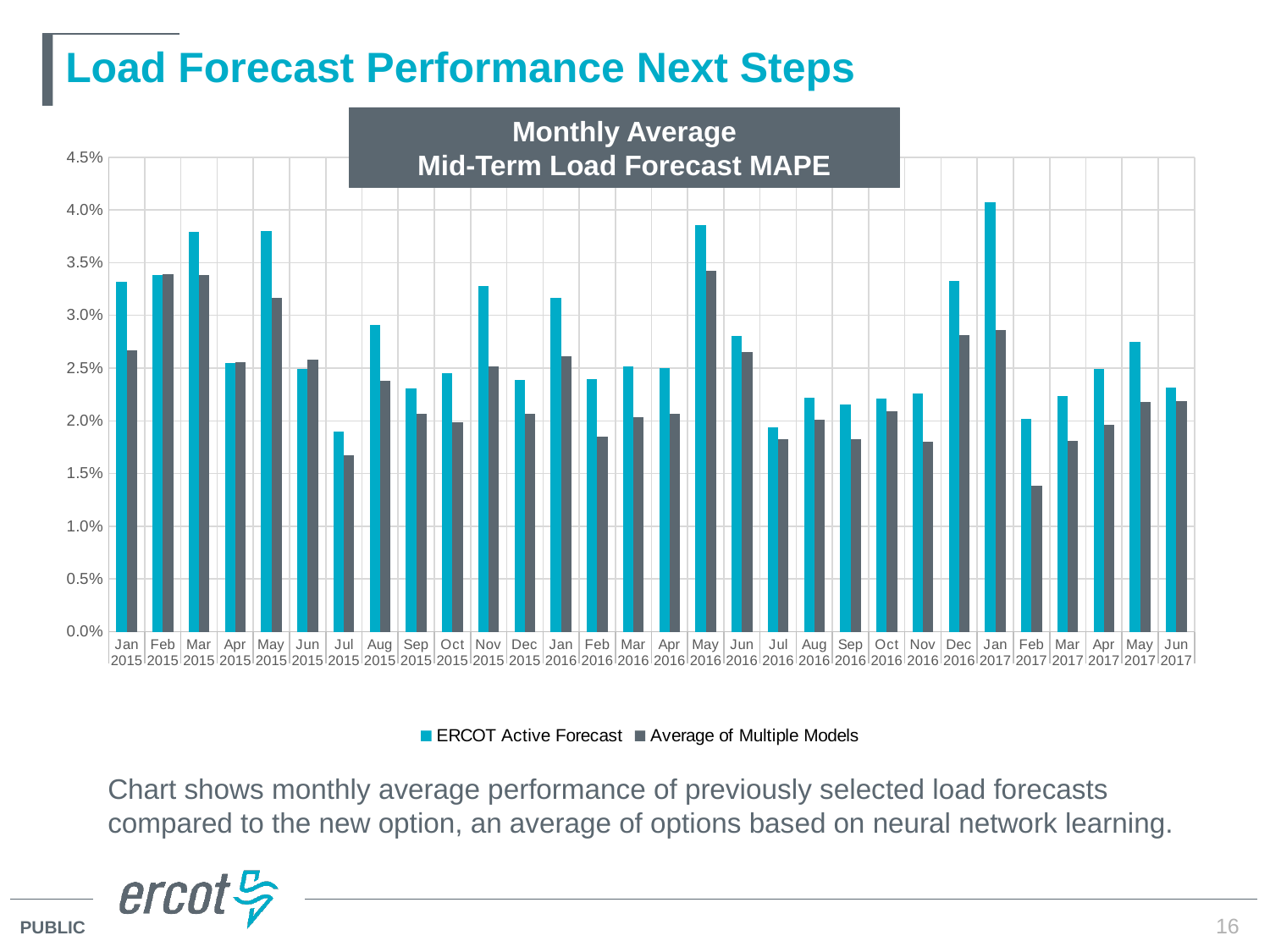
In which month is the Average of Multiple Models MAPE lowest? Feb 2017 What kind of chart is shown on the slide? Bar chart Is the Average of Multiple Models value for Feb 2017 greater or less than 1.5%? less Is the ERCOT Active Forecast value for May 2016 greater or less than 3.5%? greater Which series is shown in the teal (light blue) bars? ERCOT Active Forecast For Jan 2015, which series has the larger MAPE: ERCOT Active Forecast or Average of Multiple Models? ERCOT Active Forecast What is the title of the chart? Monthly Average Mid-Term Load Forecast MAPE Is the ERCOT Active Forecast value for Jul 2015 greater or less than 2.0%? less In which month is the ERCOT Active Forecast MAPE highest? Jan 2017 How many series does the legend list? 2 How many months are shown on the x axis of the chart? 30